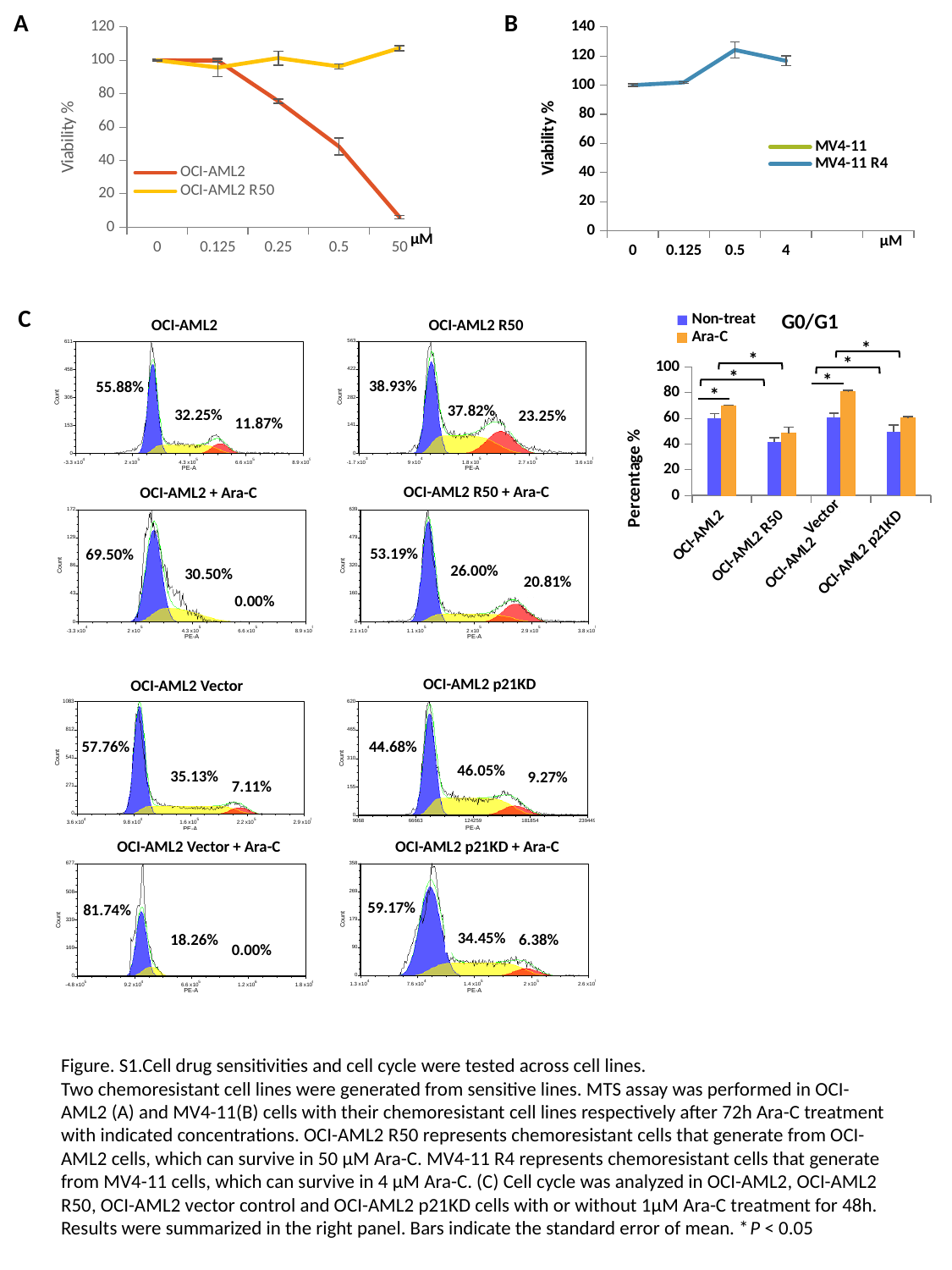
In panel A, how many series does the legend list? 2 In panel A, is the viability of OCI-AML2 at 0.5 µM greater or less than 60? less In panel B, is the viability of MV4-11 R4 at 0.5 µM greater or less than 110? greater In panel A, what kind of chart is shown? line chart In panel B, how many concentration points are shown on the x axis? 4 In the G0/G1 bar chart in panel C, which cell line has the lowest Non-treat bar? OCI-AML2 R50 In panel A, does the viability of OCI-AML2 rise or fall as the concentration increases along the x axis? fall In panel A, which series has the lower viability at 50 µM? OCI-AML2 In the OCI-AML2 + Ara-C histogram in panel C, what percentage is labeled for the blue peak? 69.50% In the G0/G1 bar chart in panel C, how many series does the legend list? 2 In panel B, how many series does the legend list? 2 In the G0/G1 bar chart in panel C, which cell line has the highest Ara-C bar? OCI-AML2 Vector